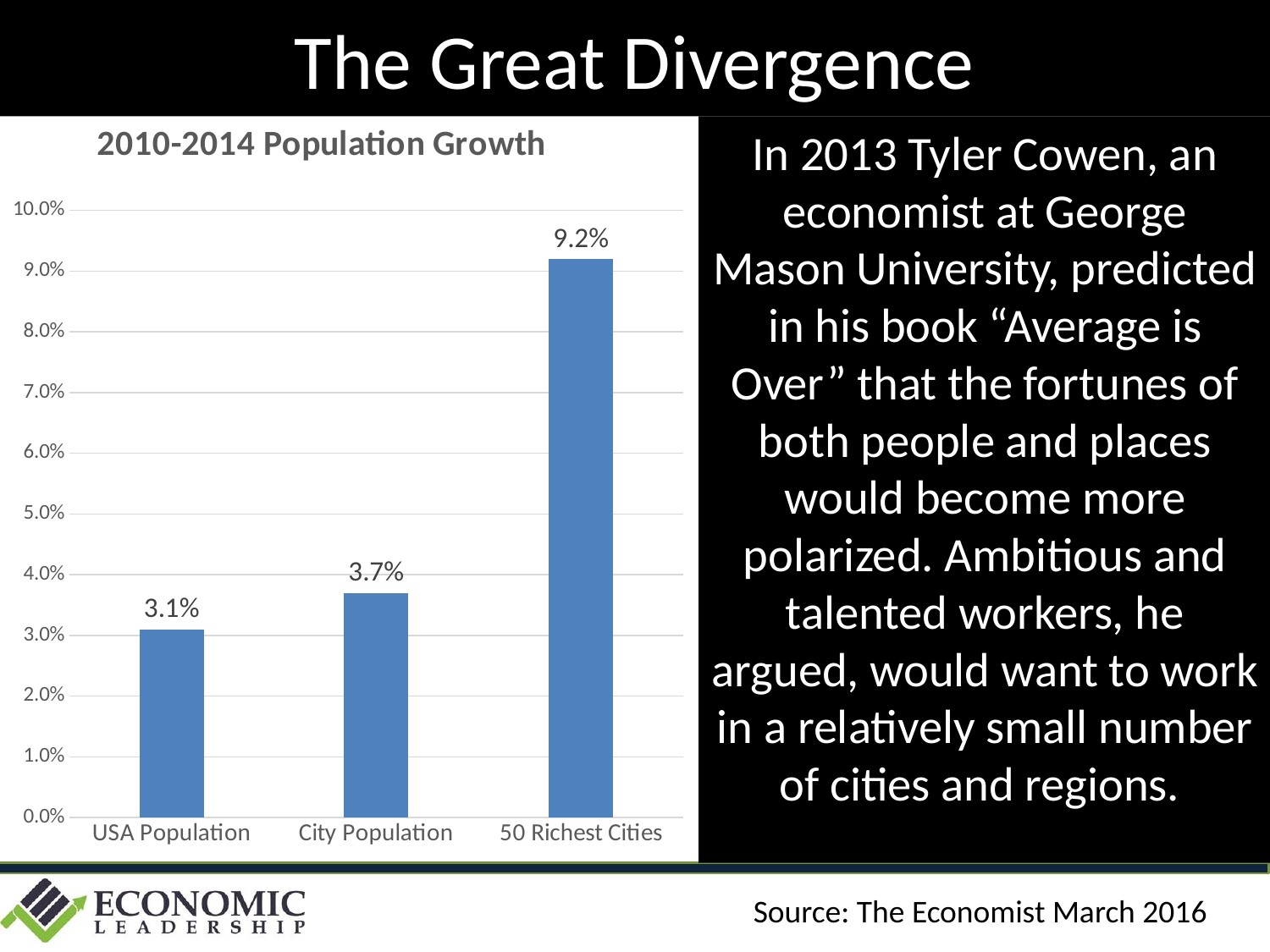
How many categories are shown in the chart? 3 Which category has the lowest population growth? USA Population What kind of chart is shown on the slide? bar chart What is the difference in population growth between City Population and USA Population? 0.6% What is the 2010-2014 population growth for USA Population? 3.1% Is the value for 50 Richest Cities greater or less than 8.0%? greater What is the 2010-2014 population growth for City Population? 3.7% What is the difference in population growth between the 50 Richest Cities and USA Population? 6.1% What is the 2010-2014 population growth for the 50 Richest Cities? 9.2% Which category has the highest population growth? 50 Richest Cities What is the title of the chart? 2010-2014 Population Growth Which is larger, the population growth for City Population or for USA Population? City Population